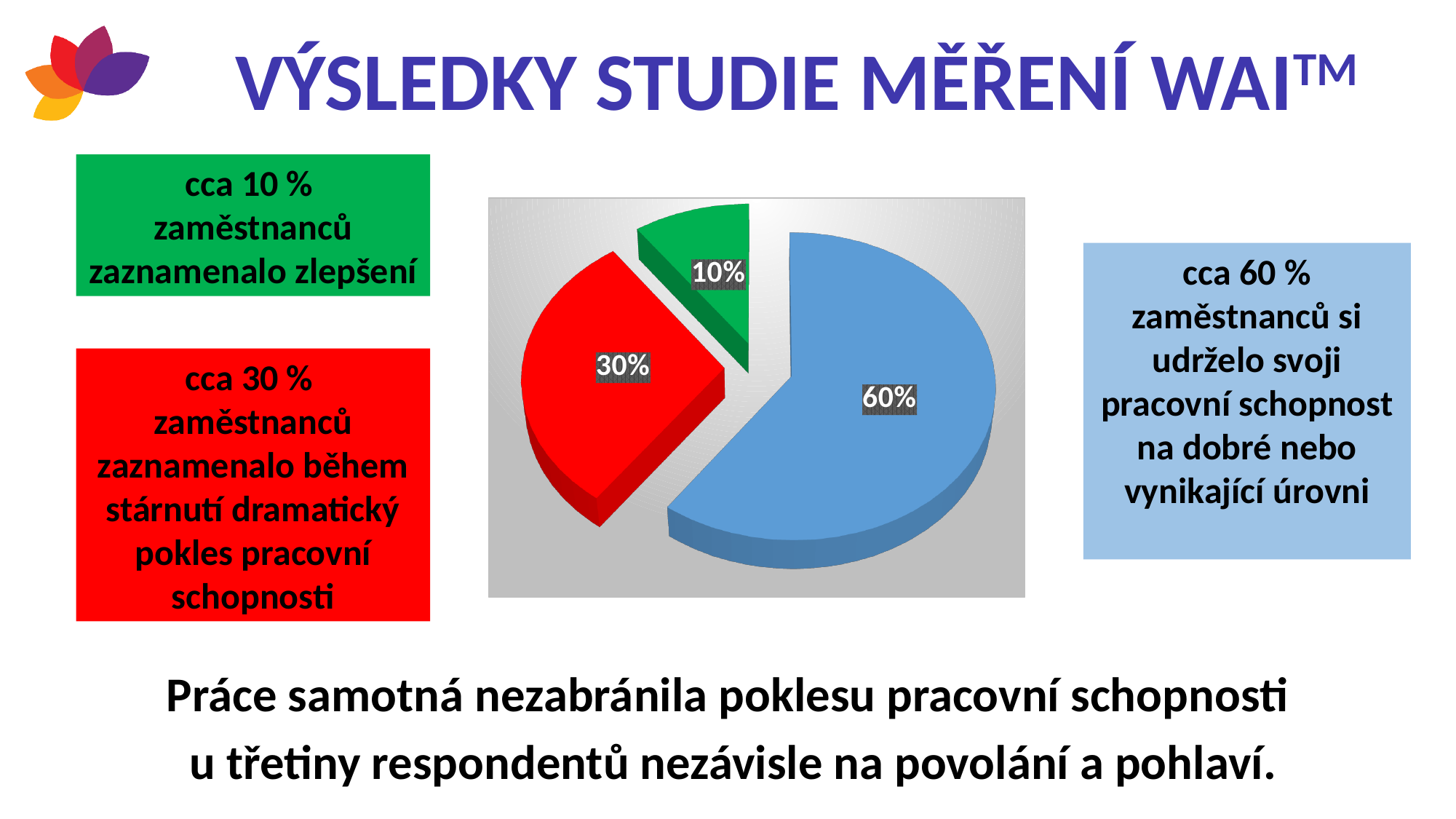
Which slice of the pie chart is the largest? the blue slice (60%) What kind of chart is shown on the slide? pie chart What colour is the slice representing employees who maintained their work ability at a good or excellent level? blue How many slices does the pie chart have? 3 Which is larger in the pie chart, the red slice or the green slice? the red slice What is the difference between the blue slice and the red slice of the pie chart? 30% What is the combined share of the red and green slices of the pie chart? 40% What percentage is shown on the green slice of the pie chart? 10% Which slice of the pie chart is the smallest? the green slice (10%) What percentage is shown on the red slice of the pie chart? 30% What share of the pie does the slice for employees who recorded an improvement (zlepšení) represent? 10% What percentage is shown on the blue slice of the pie chart? 60%